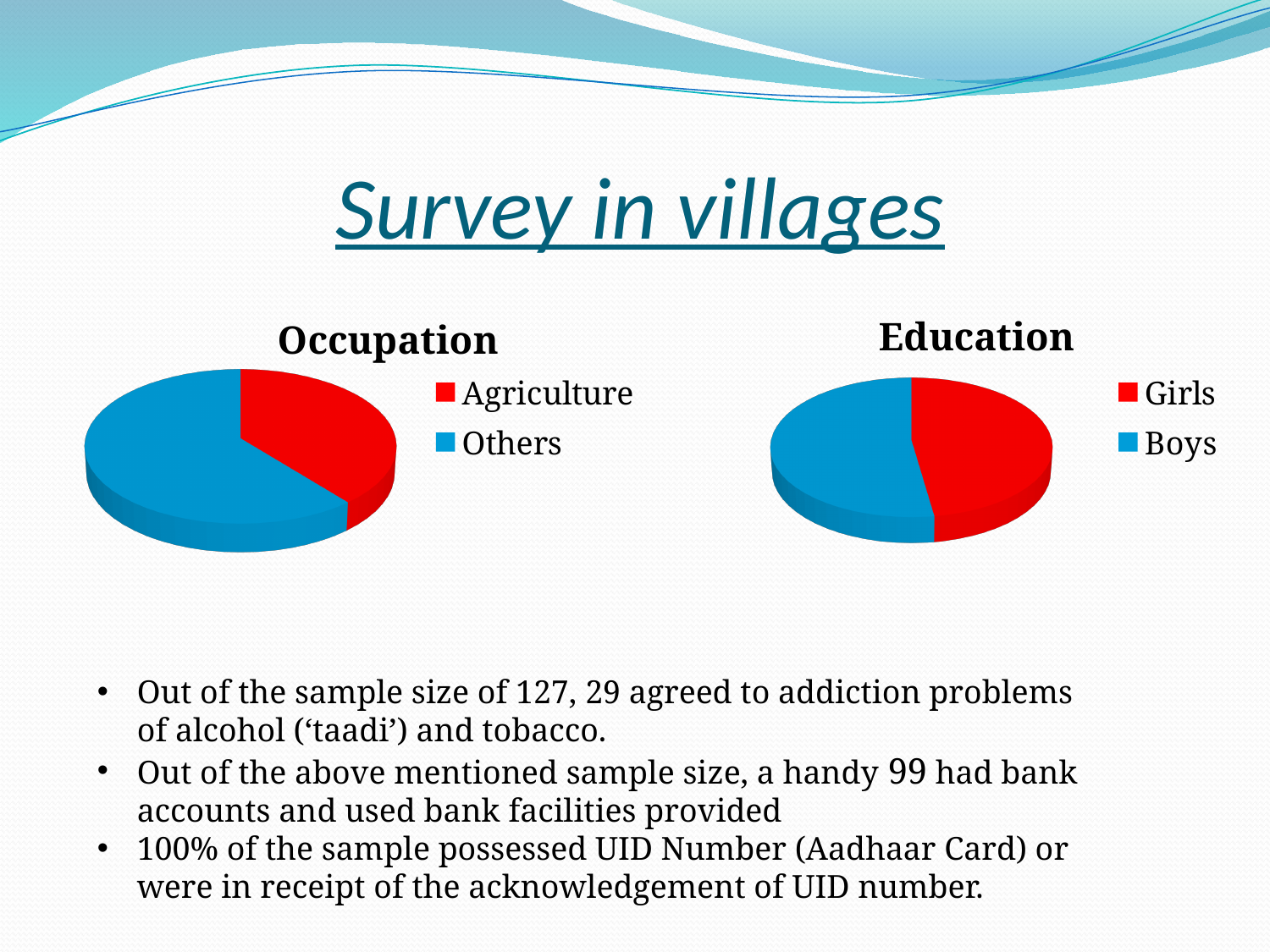
In the Occupation chart, which is larger, Agriculture or Others? Others In the Occupation chart, what colour represents Agriculture? red How many slices does the Education pie chart have? 2 In the Occupation chart, which category has the smallest slice? Agriculture What kind of chart is the Education chart? pie chart What are the two categories shown in the Education chart's legend? Girls and Boys How many entries does the legend of the Occupation chart list? 2 In the Occupation chart, which category has the largest slice? Others How many slices does the Occupation pie chart have? 2 How many entries does the legend of the Education chart list? 2 What kind of chart is the Occupation chart? pie chart